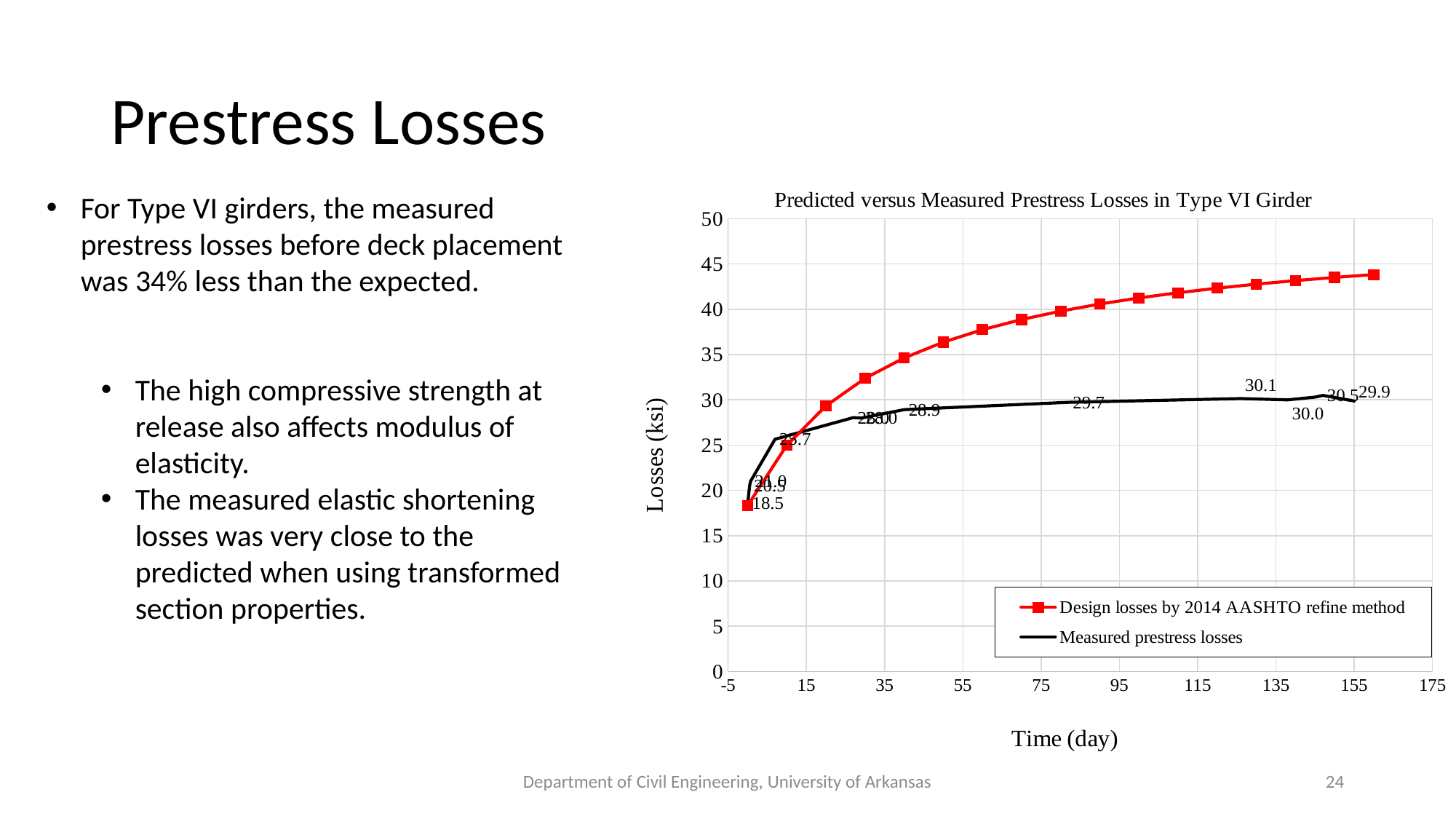
What is the difference between the labelled measured values 29.7 and 25.7? 4.0 What is the last labelled value on the Measured prestress losses line, at the right end of the chart? 29.9 At about 155 days, which series has the higher value: Design losses by 2014 AASHTO refine method or Measured prestress losses? Design losses by 2014 AASHTO refine method What is the highest labelled value on the Measured prestress losses line? 30.5 What is the title of the chart? Predicted versus Measured Prestress Losses in Type VI Girder How many series does the legend list? 2 What is the label of the y axis? Losses (ksi) What kind of chart is shown on the slide? line chart What is the first labelled value on the Measured prestress losses line? 18.5 Do the values of the Design losses by 2014 AASHTO refine method line rise or fall as time increases? rise Is the value of the Design losses by 2014 AASHTO refine method line at about 155 days greater or less than 40? greater Is the value of the Measured prestress losses line at about 75 days greater or less than 35? less